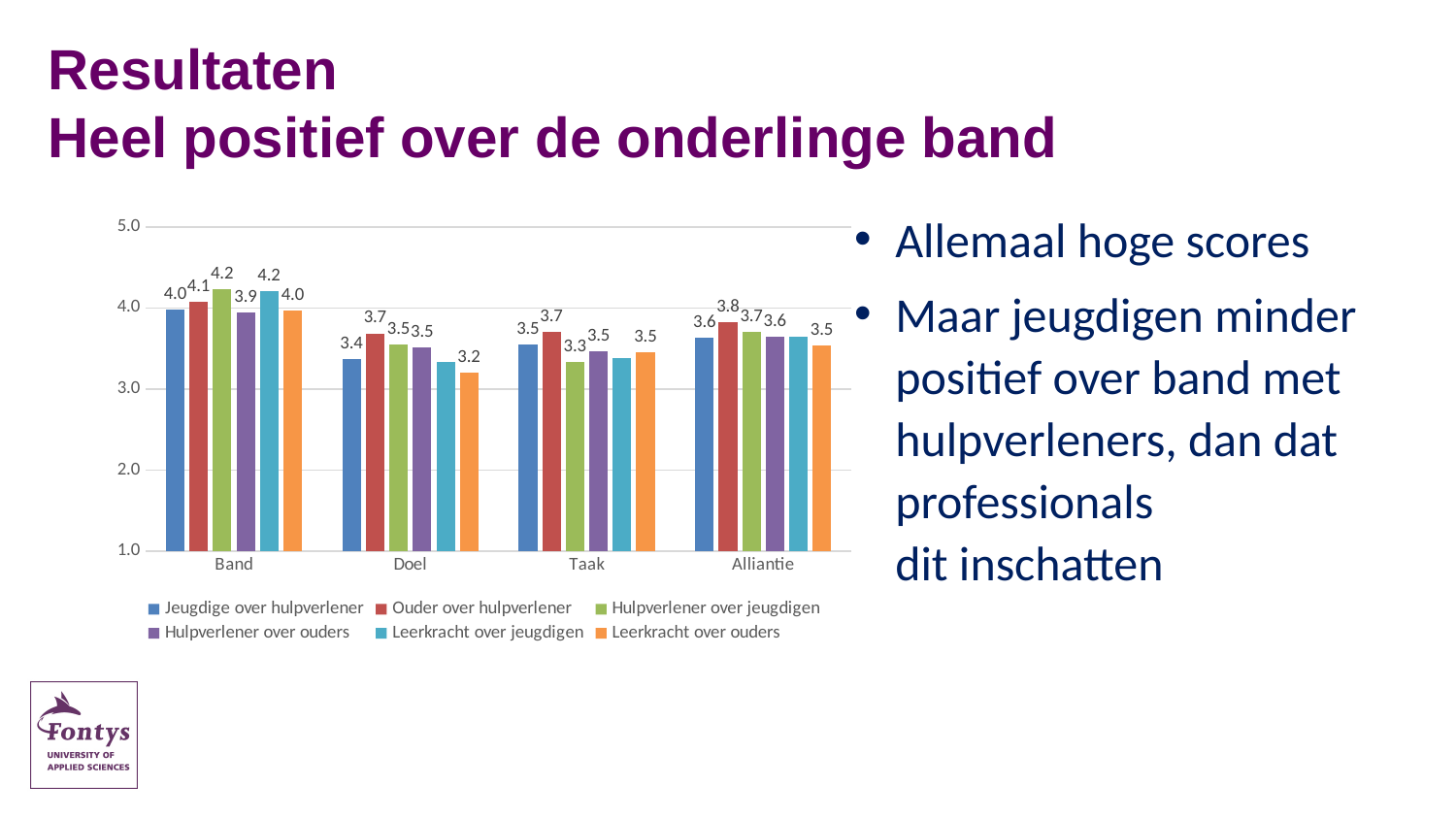
What is the value for 'Hulpverlener over jeugdigen' in the Taak category? 3.3 What is the difference between the 'Ouder over hulpverlener' values for Band and Doel? 0.4 How many categories are shown on the x axis of the chart? 4 What kind of chart is shown on the slide? bar chart How many series does the chart's legend list? 6 Which colour represents 'Ouder over hulpverlener' in the chart's legend? red What is the value for 'Leerkracht over ouders' in the Doel category? 3.2 In which category is the value for 'Leerkracht over ouders' the lowest? Doel What is the value for 'Ouder over hulpverlener' in the Band category? 4.1 Is the value for 'Hulpverlener over ouders' in the Band category greater or less than 3.0? greater In which category is the value for 'Ouder over hulpverlener' the highest? Band For 'Jeugdige over hulpverlener', which category has the larger value: Band or Alliantie? Band